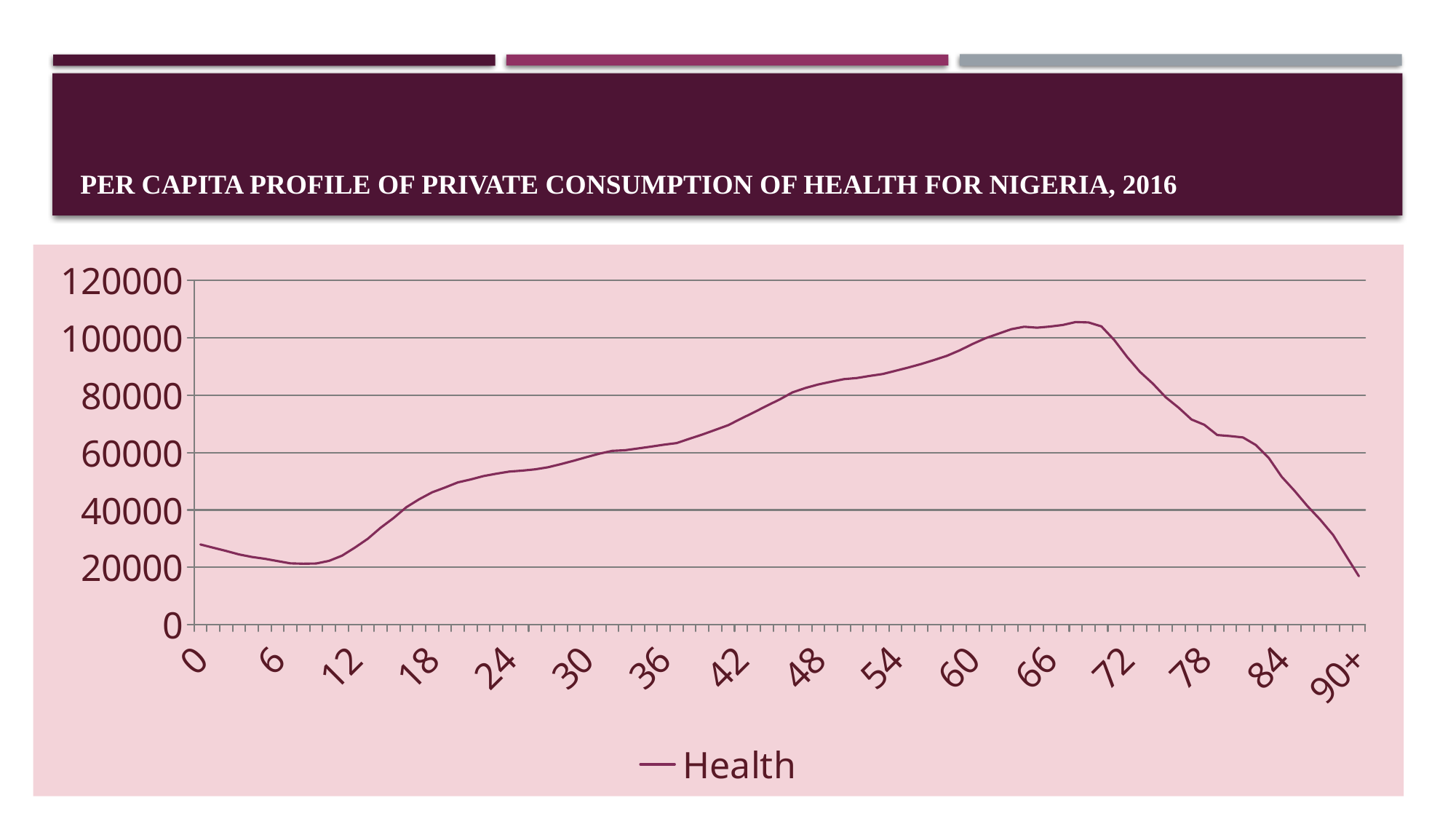
How many age labels are shown along the x axis? 16 Does the Health value rise or fall along the x axis between age 12 and age 66? rise Is the value for age 0 greater or less than 20000? greater Is the value for age 84 greater or less than 60000? less Is the value for age 90+ greater or less than 20000? less What is the name of the series shown in the legend? Health What is the title of the slide containing the chart? Per capita profile of private consumption of health for Nigeria, 2016 How many series does the legend list? 1 What kind of chart is shown on the slide? line chart Which has the larger Health value, age 6 or age 66? 66